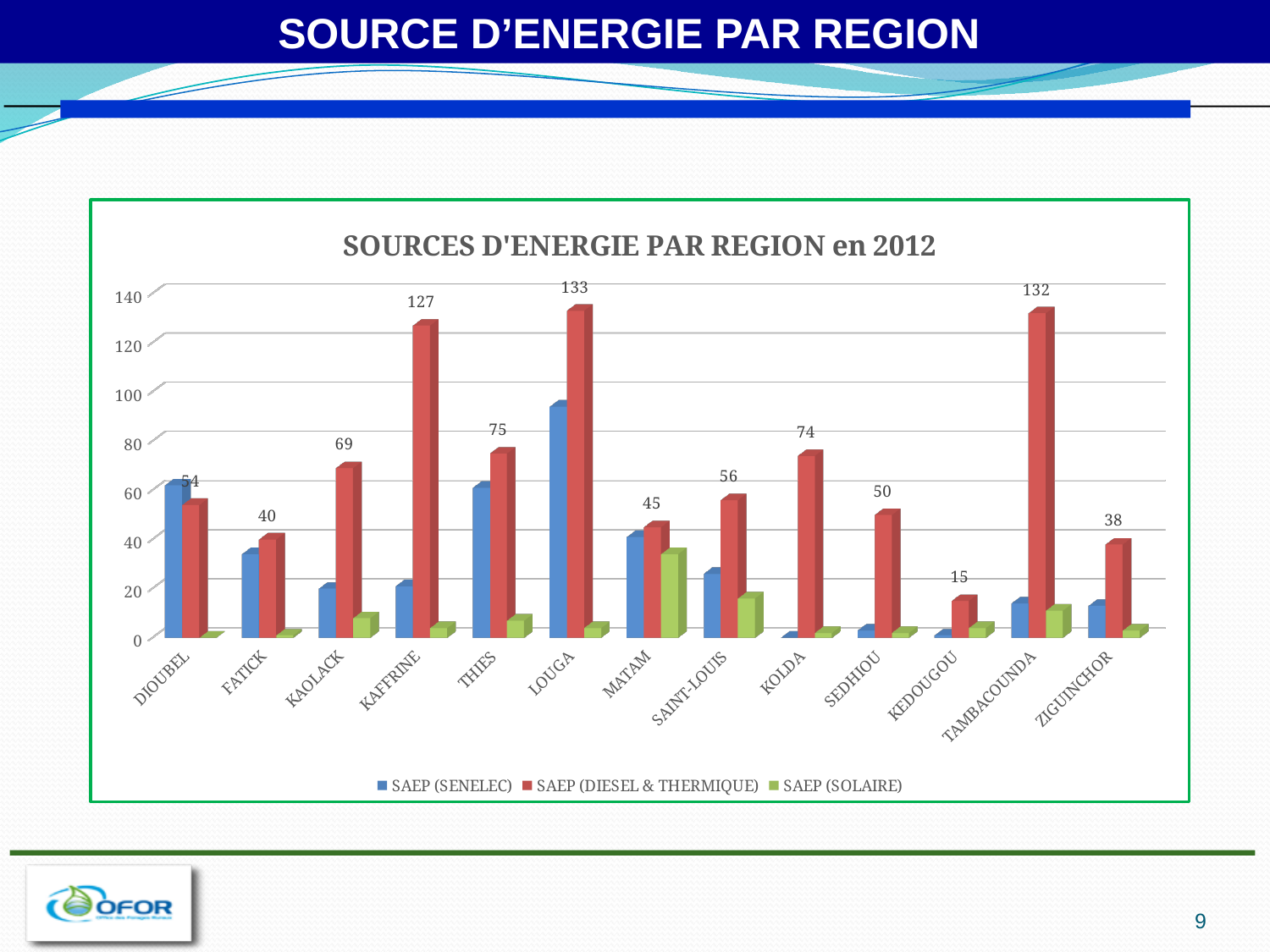
How many series does the legend list? 3 Is the SAEP (SENELEC) value for LOUGA greater or less than 80? greater What is the value of SAEP (DIESEL & THERMIQUE) for SEDHIOU? 50 Is the SAEP (SOLAIRE) value for MATAM greater or less than 20? greater Which region has a larger SAEP (DIESEL & THERMIQUE) value, THIES or KOLDA? THIES What is the difference between the SAEP (DIESEL & THERMIQUE) values for KAFFRINE and ZIGUINCHOR? 89 How many regions are shown on the x axis of the chart? 13 What is the value of SAEP (DIESEL & THERMIQUE) for KAFFRINE? 127 Which region has the highest value for SAEP (DIESEL & THERMIQUE)? LOUGA What is the value of SAEP (DIESEL & THERMIQUE) for MATAM? 45 What type of chart is shown on the slide? Bar chart Which region has the lowest value for SAEP (DIESEL & THERMIQUE)? KEDOUGOU